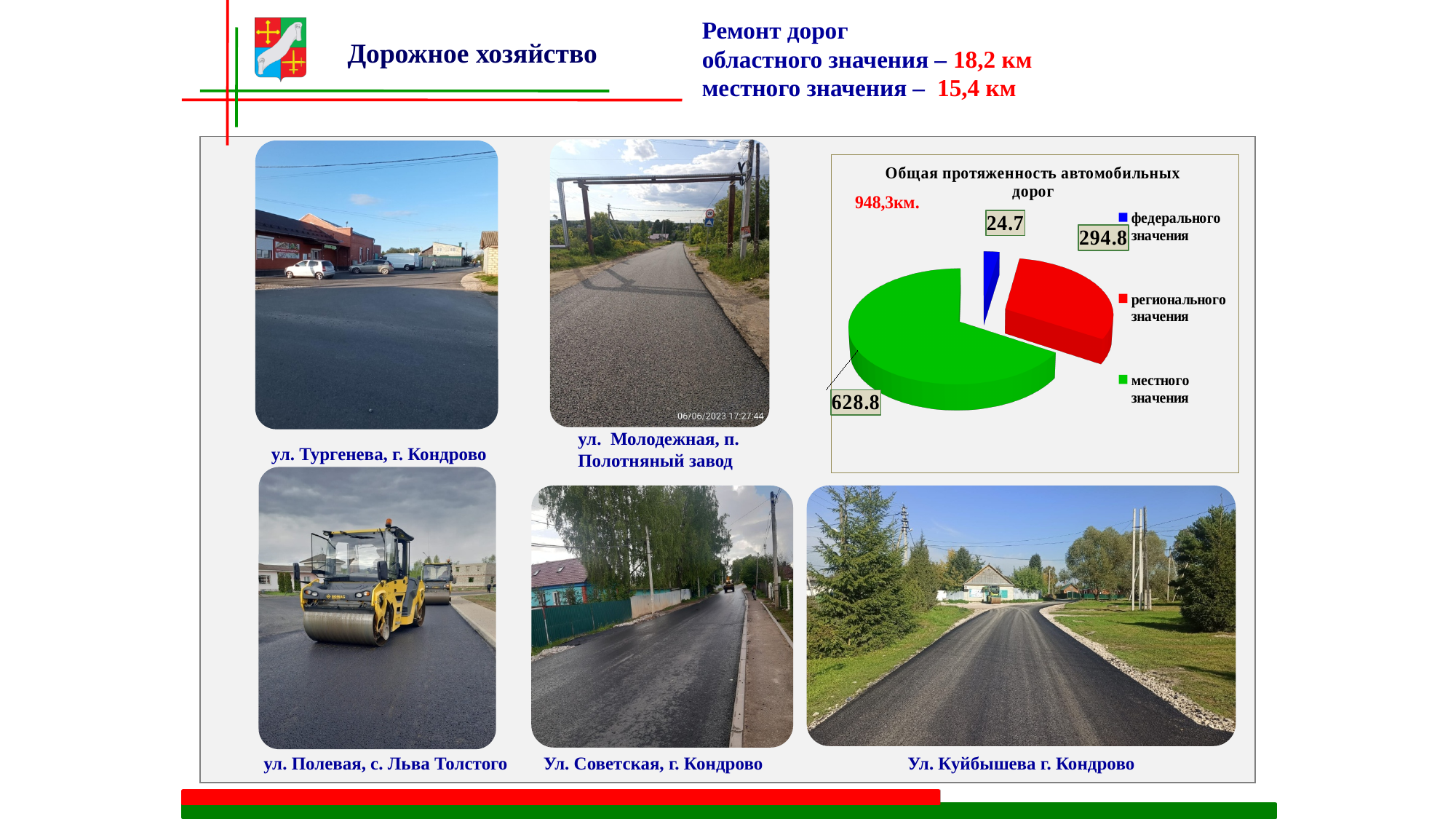
What total length is printed next to the pie chart? 948,3км. What colour is the 'местного значения' slice in the pie chart? green Which category has the smallest slice in the pie chart? федерального значения Which is larger in the pie chart: 'регионального значения' or 'федерального значения'? регионального значения What is the value for the 'местного значения' slice in the pie chart? 628.8 What is the title of the pie chart? Общая протяженность автомобильных дорог What kind of chart is shown on the slide? pie chart What is the value for the 'федерального значения' slice in the pie chart? 24.7 Which category has the largest slice in the pie chart? местного значения What is the value for the 'регионального значения' slice in the pie chart? 294.8 How many categories does the pie chart legend list? 3 What is the difference between the 'местного значения' and 'регионального значения' values in the pie chart? 334.0